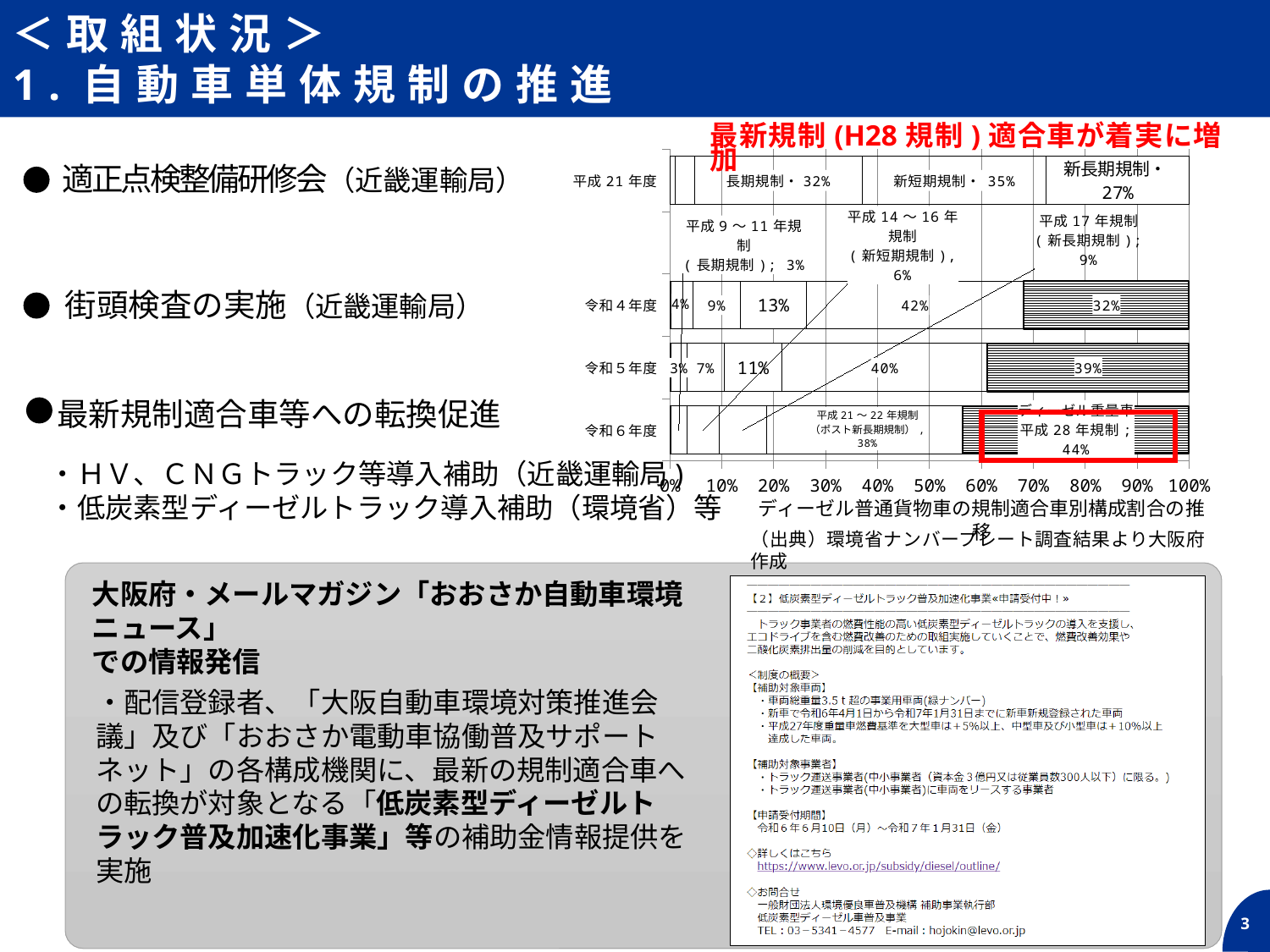
By how many percentage points does the 平成28年規制 share in 令和6年度 exceed that in 令和5年度? 5 Does the share of 平成28年規制 vehicles rise or fall from 令和4年度 to 令和6年度? rise What is the share of the 平成21～22年規制 (ポスト新長期規制) segment in 令和6年度? 38% How many fiscal years (categories) are plotted on the chart? 4 What is the share of the 平成28年規制 segment in 令和4年度? 32% What is the title of the chart? ディーゼル普通貨物車の規制適合車別構成割合の推移 What kind of chart is shown on the slide? bar chart What is the share of 平成28年規制 vehicles in 令和6年度? 44% What is the share of 長期規制 vehicles in 平成21年度? 32% In 令和6年度, which is larger: the 平成21～22年規制 (ポスト新長期規制) segment or the 平成28年規制 segment? 平成28年規制 What is the share of the 平成28年規制 segment in 令和5年度? 39% What is the share of 新短期規制 vehicles in 平成21年度? 35%